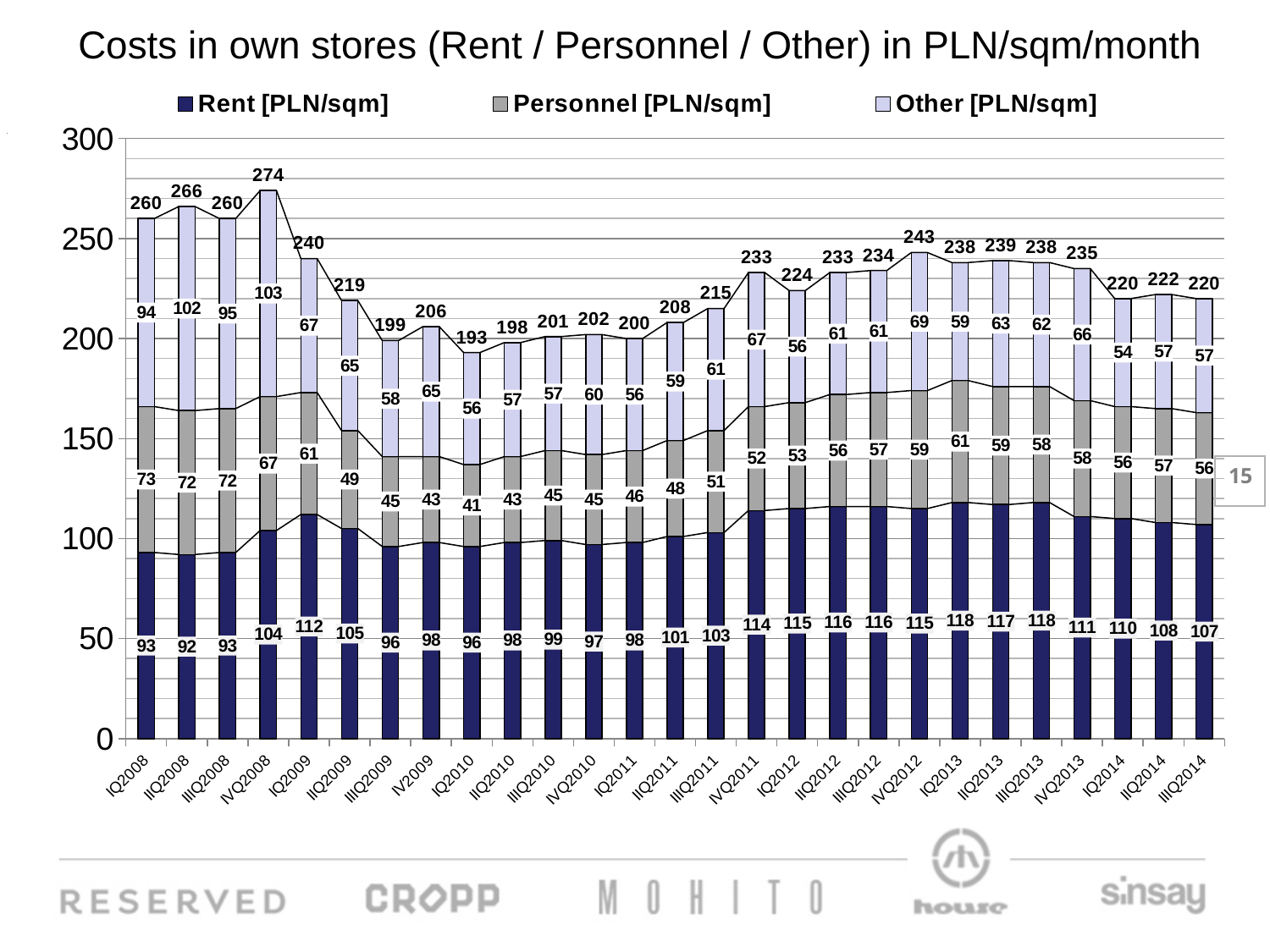
What is the Other [PLN/sqm] value for IVQ2012? 69 What is the difference between the total cost in IVQ2008 and the total cost in IQ2010? 81 What kind of chart is shown on the slide? Stacked bar chart What is the total cost for IVQ2008? 274 Which quarter has the lowest Personnel [PLN/sqm] value? IQ2010 How many quarters are shown on the x axis? 27 Which quarter has the lowest total cost? IQ2010 Which quarter has the highest total cost? IVQ2008 How many series does the legend list? 3 What is the Personnel [PLN/sqm] value for IQ2010? 41 Which is larger, the Rent [PLN/sqm] value for IQ2013 or for IIIQ2014? IQ2013 What is the Rent [PLN/sqm] value for IQ2009? 112